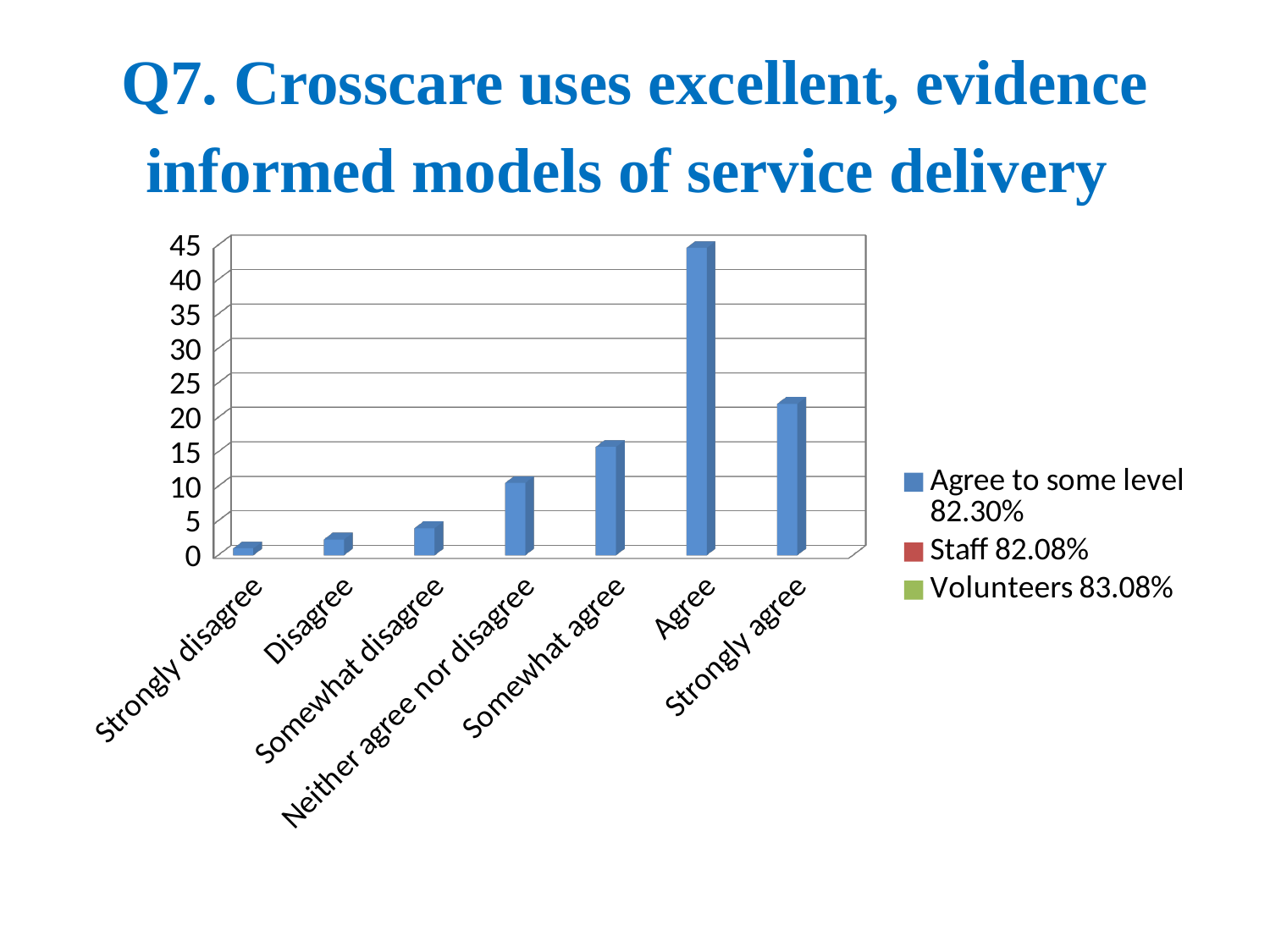
Which category has the highest bar in the chart? Agree How many entries does the chart's legend list? 3 What kind of chart is shown on the slide? bar chart Is the value for Strongly agree greater or less than 25? less Which category has the lowest bar in the chart? Strongly disagree Is the value for Somewhat agree greater or less than 20? less Do the values rise or fall along the x axis from Strongly disagree to Agree? rise Which is larger, the value for Agree or the value for Strongly agree? Agree Is the value for Agree greater or less than 40? greater How many categories are shown on the x axis of the chart? 7 What percentage is shown next to the Staff entry in the legend? 82.08%